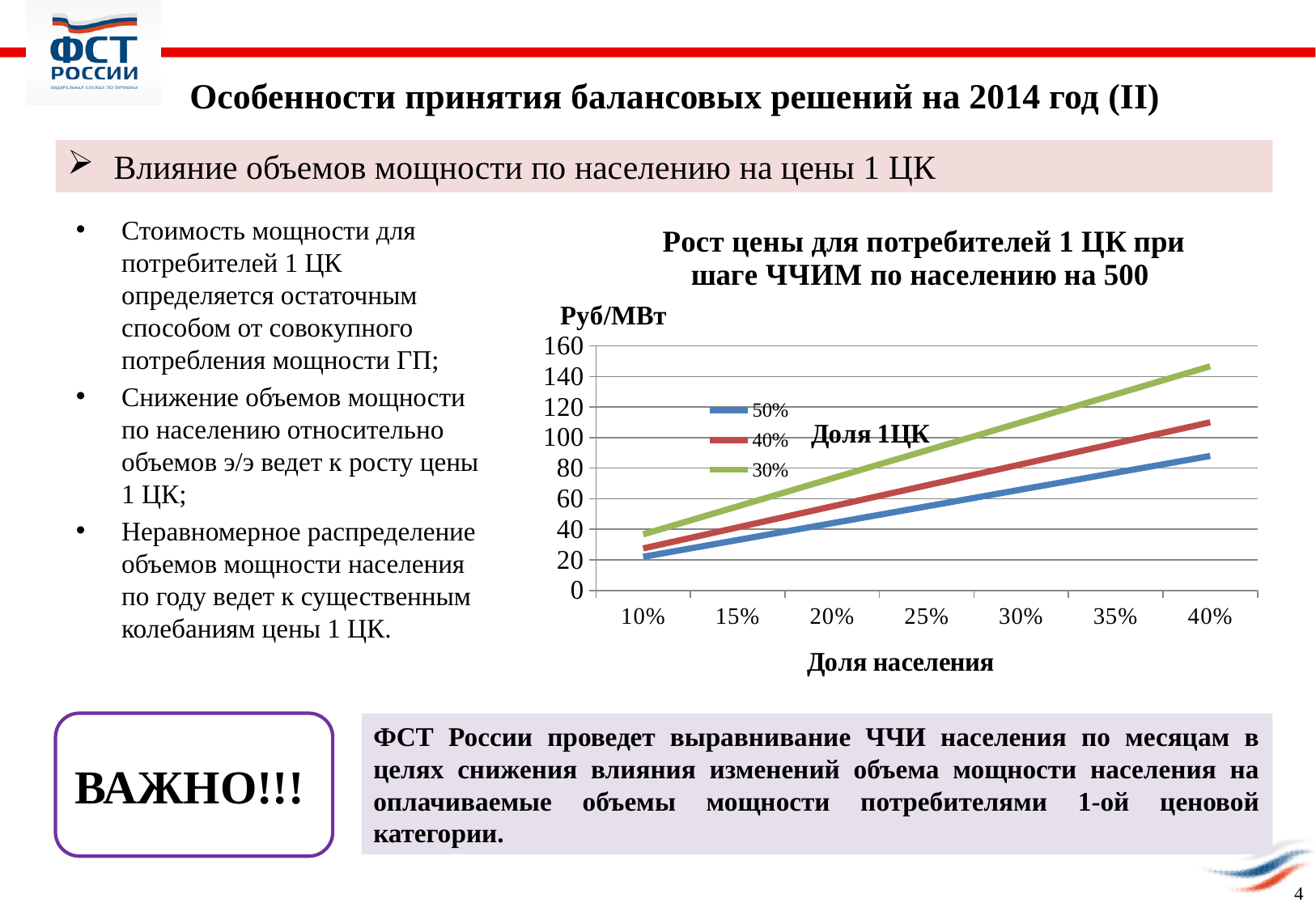
What kind of chart is shown on the slide? line chart Is the value of the 50% series at a population share of 10% greater or less than 40? less What unit is shown on the y axis of the chart? Руб/МВт Is the value of the 30% series at a population share of 40% greater or less than 140? greater How many series does the chart legend list? 3 What is the title of the chart? Рост цены для потребителей 1 ЦК при шаге ЧЧИМ по населению на 500 At a population share of 25%, which is larger: the value of the 30% series or the value of the 50% series? 30% series Do the values of the 30% series rise or fall as the share of population increases along the x axis? rise How many categories are shown along the x axis of the chart? 7 Which series has the lowest value at a population share of 40%? 50% Which series has the highest value at a population share of 40%? 30% Is the value of the 40% series at a population share of 40% greater or less than 100? greater